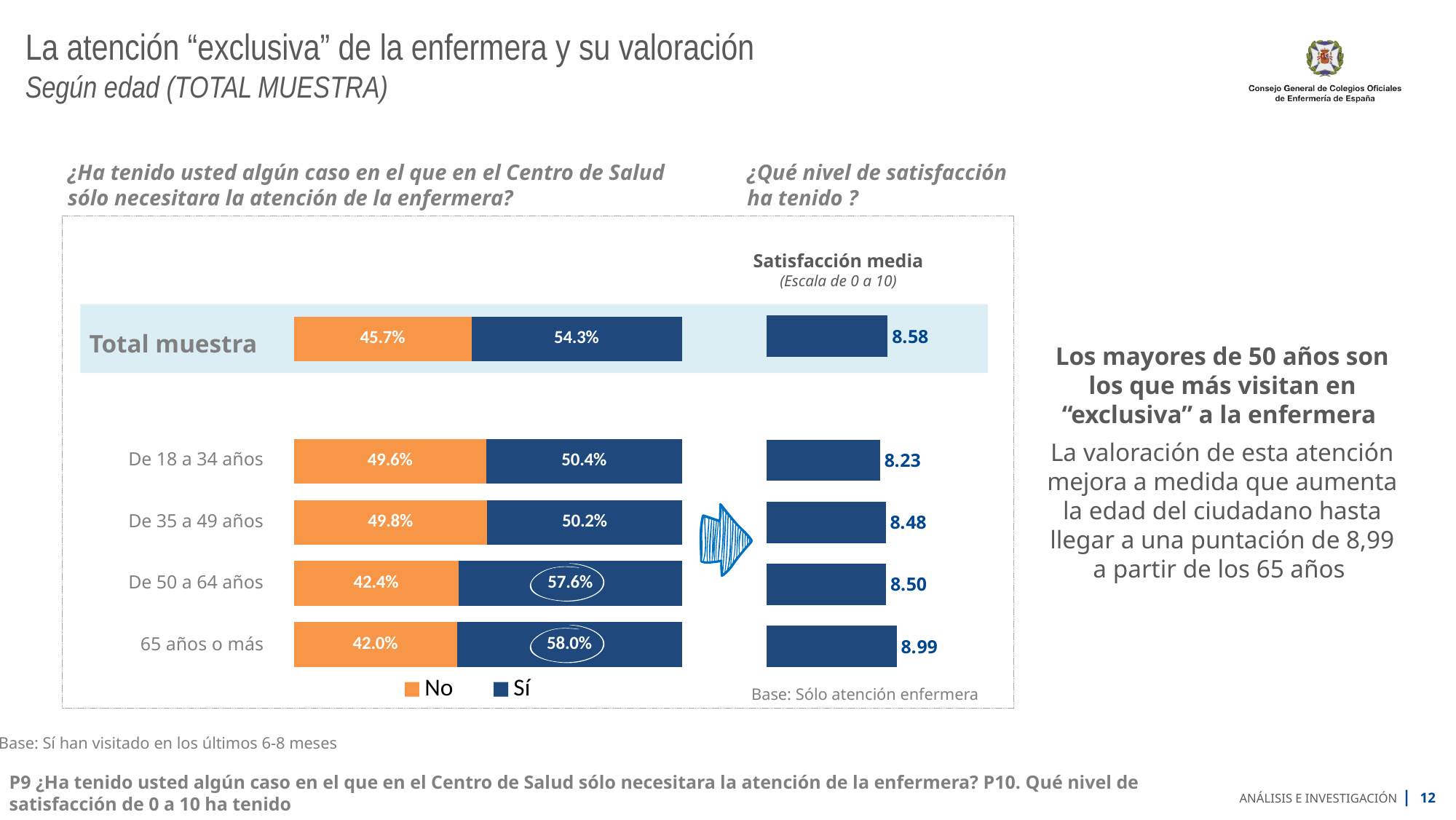
In the 'Satisfacción media' chart on the right, what is the difference between the values for '65 años o más' and 'Total muestra'? 0.41 In the left stacked bar chart, which age group has the highest 'Sí' percentage? 65 años o más In the left stacked bar chart, is the 'No' percentage for 'De 50 a 64 años' larger or smaller than for 'De 18 a 34 años'? smaller In the 'Satisfacción media' chart on the right, which age group has the lowest value? De 18 a 34 años How many series does the legend of the left stacked bar chart list? 2 In the left stacked bar chart, what is the 'No' percentage for 'De 35 a 49 años'? 49.8% In the 'Satisfacción media' chart on the right, what is the value for '65 años o más'? 8.99 In the 'Satisfacción media' chart on the right, do the values rise or fall as age increases from 'De 18 a 34 años' to '65 años o más'? rise In the 'Satisfacción media' chart on the right, what is the value for 'De 18 a 34 años'? 8.23 In the left stacked bar chart, what is the difference between the 'Sí' percentages for '65 años o más' and 'De 18 a 34 años'? 7.6% In the 'Satisfacción media' chart on the right, which age group has the highest value? 65 años o más In the left stacked bar chart, what percentage of the 'Total muestra' answered 'Sí'? 54.3%